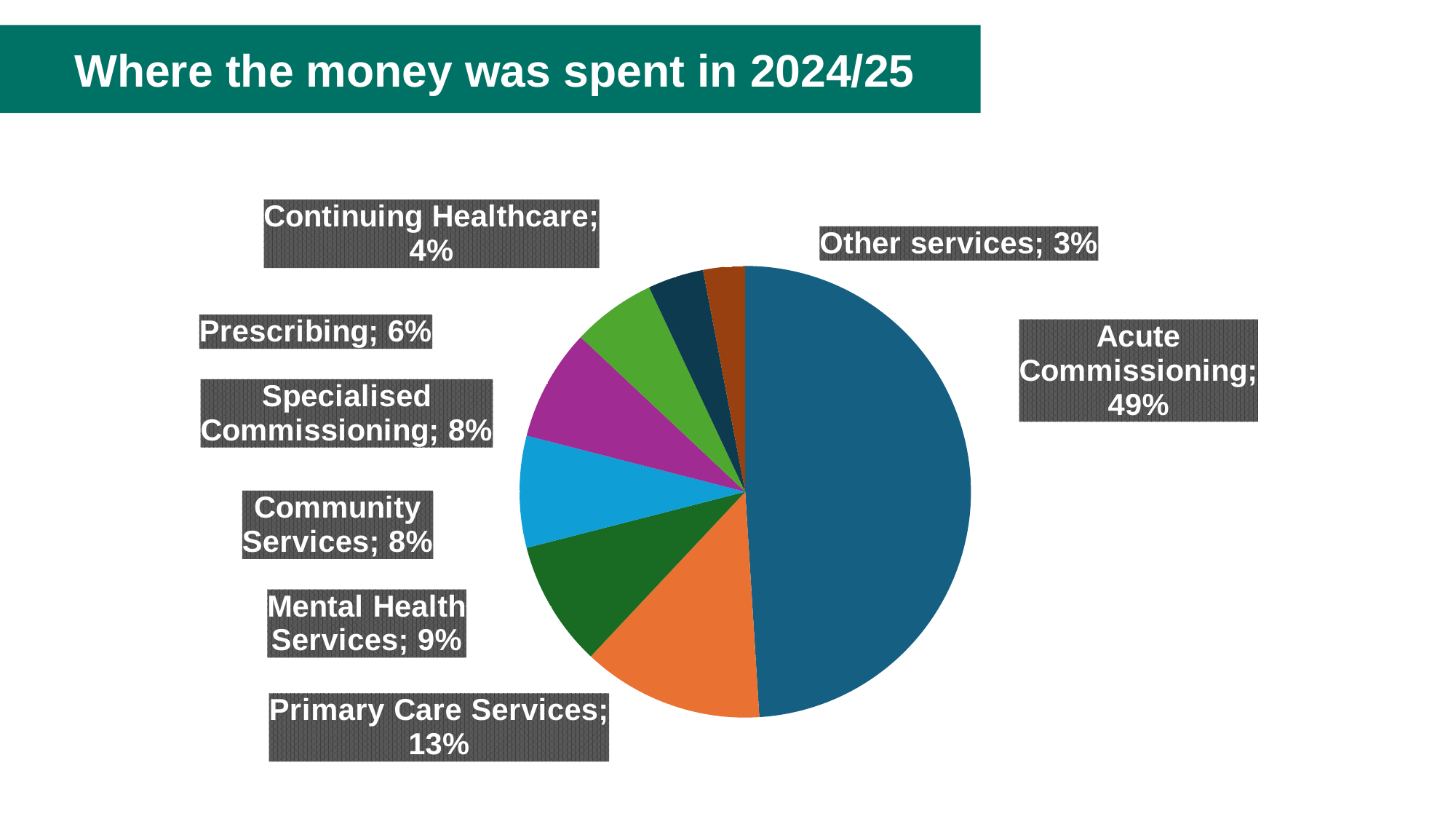
How many categories are shown in the pie chart? 8 What percentage was spent on Primary Care Services? 13% What is the title of the slide? Where the money was spent in 2024/25 What type of chart is shown on the slide? Pie chart What share of spending went to Acute Commissioning? 49% What is the difference in percentage points between Primary Care Services and Mental Health Services? 4 What percentage was spent on Prescribing? 6% What is the combined share of Specialised Commissioning and Community Services? 16% What percentage was spent on Mental Health Services? 9% Which is larger, the share for Prescribing or the share for Continuing Healthcare? Prescribing Which category received the smallest share of spending? Other services Which category received the largest share of spending? Acute Commissioning